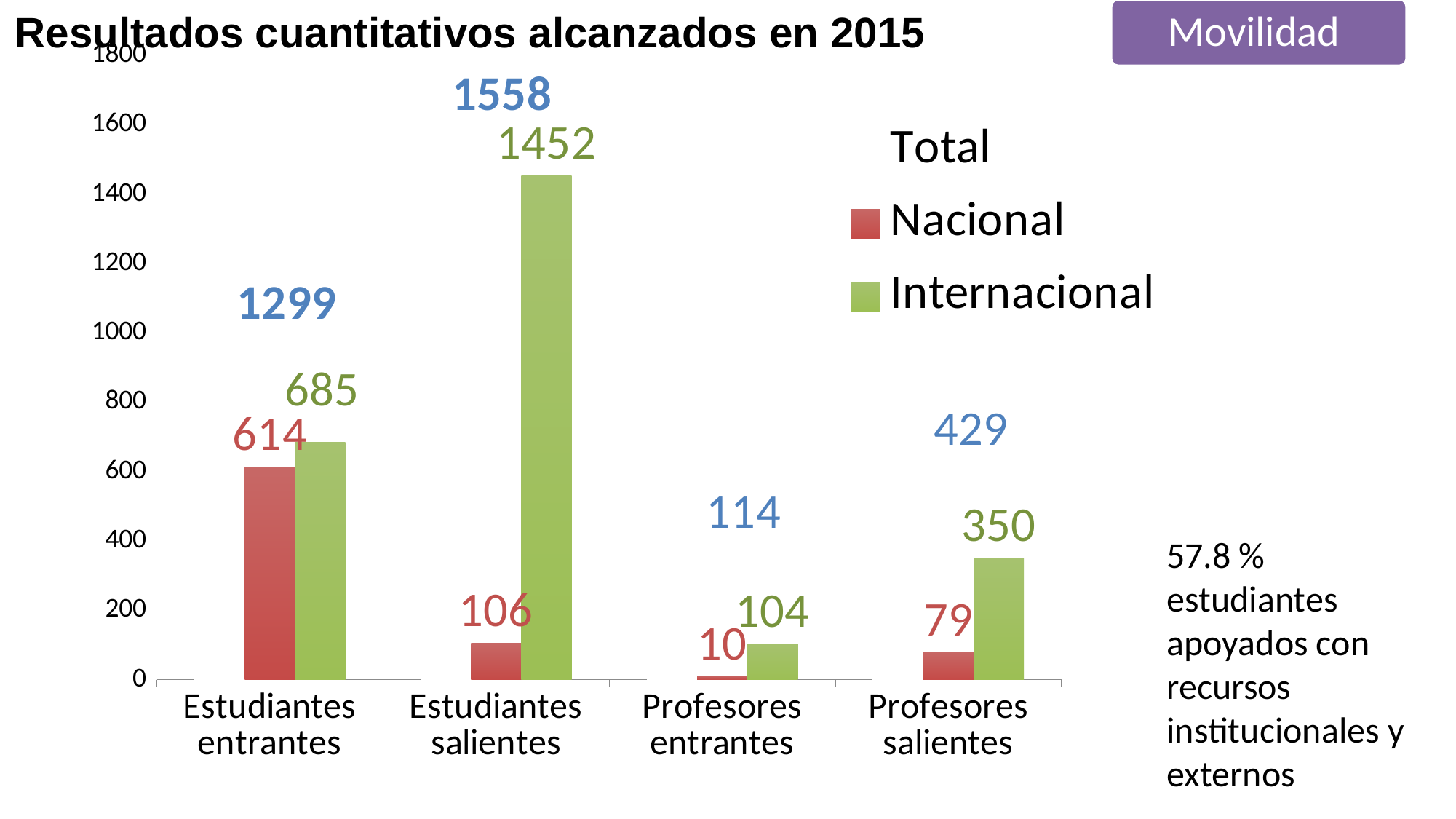
What is the Internacional value for Estudiantes salientes? 1452 What is the difference between the Internacional and Nacional values for Estudiantes entrantes? 71 Which is larger for Profesores salientes, the Nacional or the Internacional value? Internacional What kind of chart is shown on the slide? Bar chart What is the total (Nacional plus Internacional) shown above the bars for Estudiantes salientes? 1558 Which category has the lowest Nacional value? Profesores entrantes What is the Nacional value for Estudiantes entrantes? 614 How many categories are shown on the x axis? 4 Which category has the highest Internacional value? Estudiantes salientes What is the Nacional value for Profesores entrantes? 10 How many series does the legend list? 3 What is the Internacional value for Profesores salientes? 350